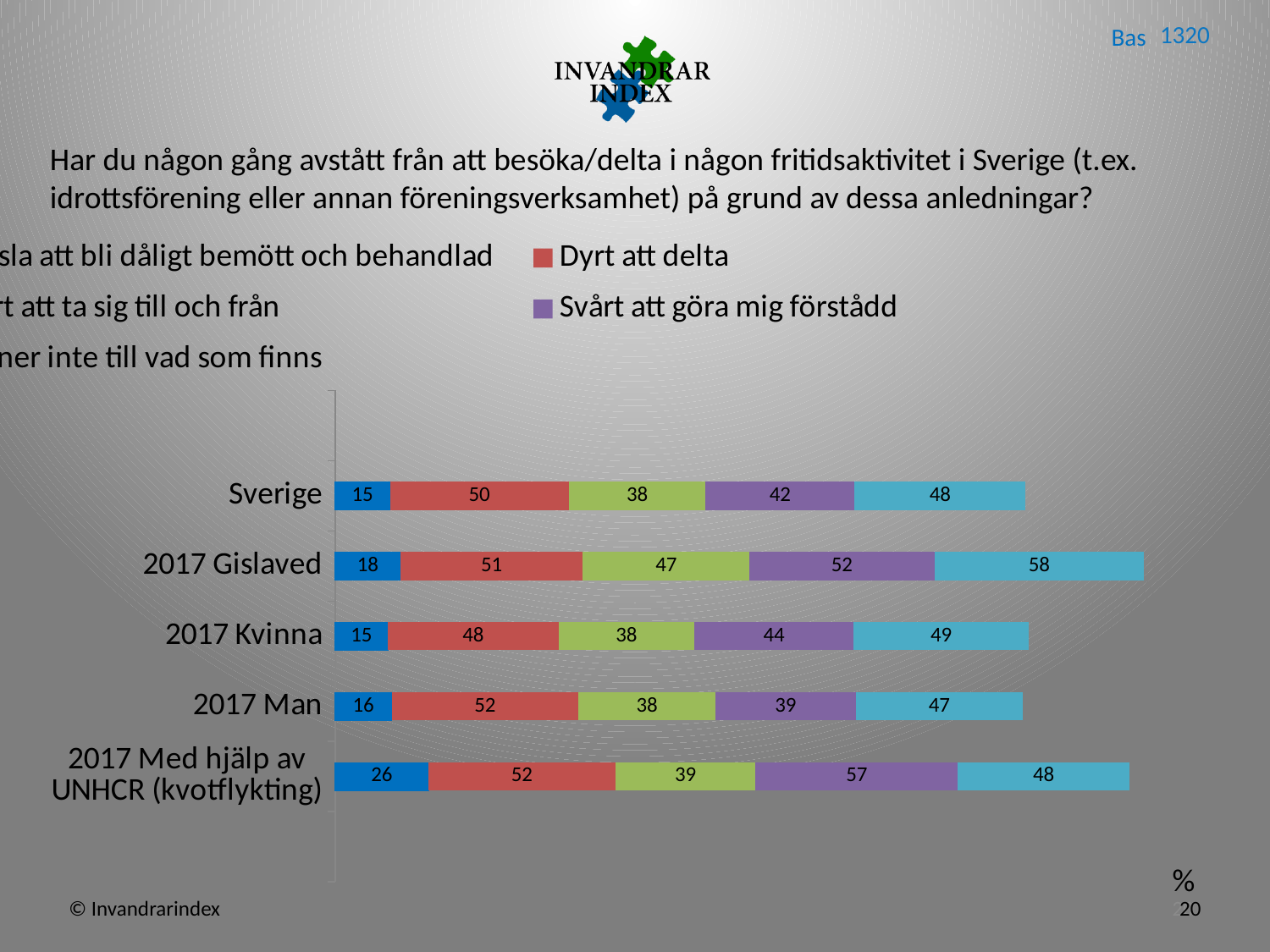
What is the value of "Dyrt att delta" for Sverige? 50 Which has a larger value for "Dyrt att delta": 2017 Gislaved or 2017 Kvinna? 2017 Gislaved What is the difference between the "Svårt att göra mig förstådd" values for 2017 Med hjälp av UNHCR (kvotflykting) and Sverige? 15 What kind of chart is shown on the slide? Stacked bar chart What is the total of the stacked bar for 2017 Gislaved? 226 How many categories are shown on the vertical axis of the chart? 5 Which category has the lowest value for "Svårt att göra mig förstådd"? 2017 Man What is the value of "Svårt att göra mig förstådd" for 2017 Gislaved? 52 Which colour represents "Dyrt att delta" in the legend? Red Which category has the highest value for "Svårt att göra mig förstådd"? 2017 Med hjälp av UNHCR (kvotflykting) How many series does the legend list? 5 What is the value of the first (blue) segment for 2017 Med hjälp av UNHCR (kvotflykting)? 26